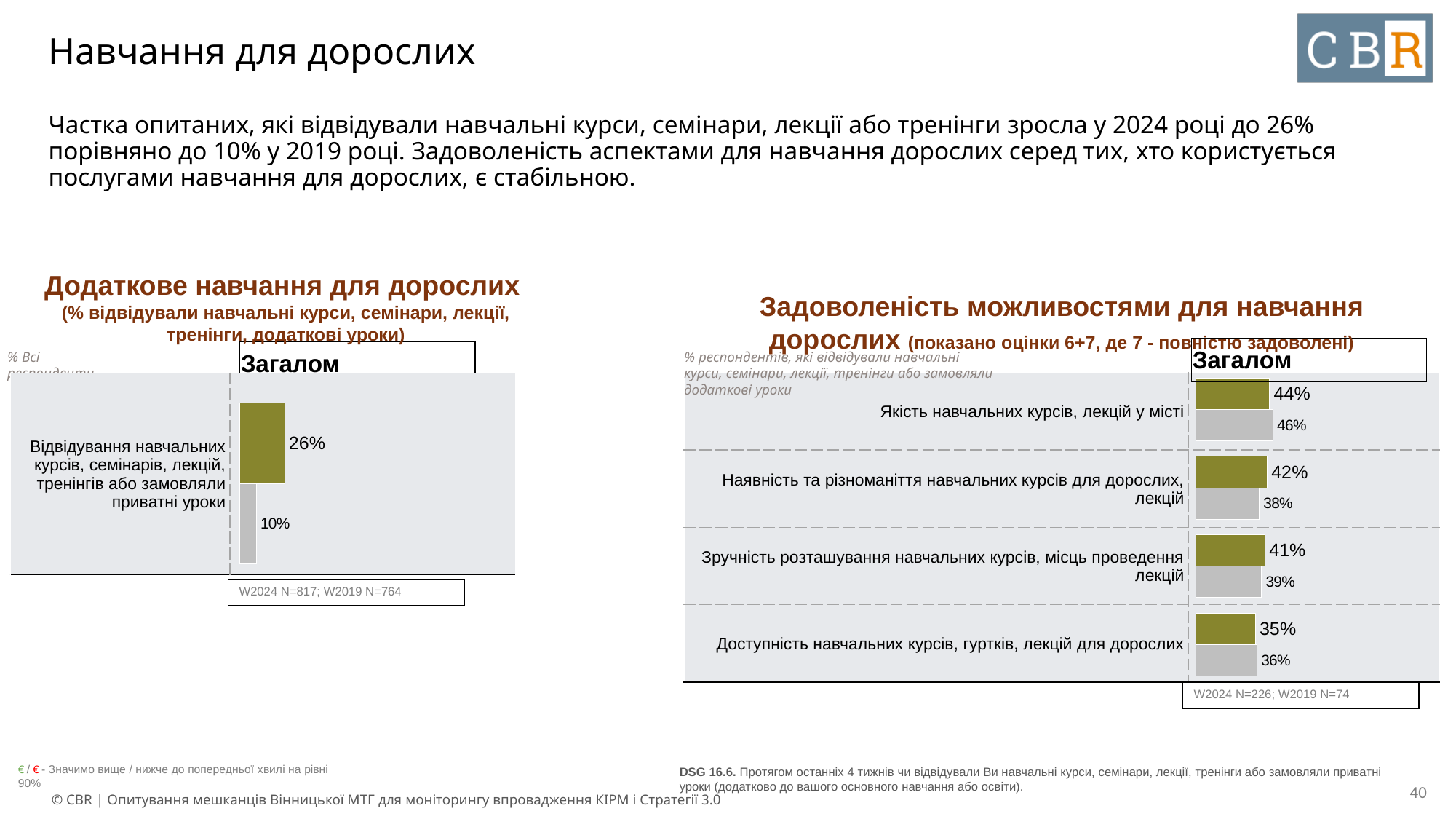
In the chart 'Додаткове навчання для дорослих', what is the value shown on the olive (upper) bar? 26% In the chart 'Задоволеність можливостями для навчання дорослих', what is the olive bar value for 'Якість навчальних курсів, лекцій у місті'? 44% In the chart 'Задоволеність можливостями для навчання дорослих', what is the difference between the olive and grey bar values for 'Наявність та різноманіття навчальних курсів для дорослих, лекцій'? 4 percentage points In the chart 'Задоволеність можливостями для навчання дорослих', which category has the highest olive bar value? Якість навчальних курсів, лекцій у місті What sample sizes are noted below the chart 'Задоволеність можливостями для навчання дорослих'? W2024 N=226; W2019 N=74 How many categories are shown in the chart 'Задоволеність можливостями для навчання дорослих'? 4 In the chart 'Додаткове навчання для дорослих', what is the difference between the olive bar value and the grey bar value? 16 percentage points In the chart 'Задоволеність можливостями для навчання дорослих', what is the grey bar value for 'Наявність та різноманіття навчальних курсів для дорослих, лекцій'? 38% What type of chart is 'Задоволеність можливостями для навчання дорослих'? Bar chart In the chart 'Задоволеність можливостями для навчання дорослих', for 'Доступність навчальних курсів, гуртків, лекцій для дорослих', which is larger: the olive bar (35%) or the grey bar (36%)? The grey bar (36%) In the chart 'Додаткове навчання для дорослих', what is the value shown on the grey (lower) bar? 10% In the chart 'Задоволеність можливостями для навчання дорослих', which category has the lowest olive bar value? Доступність навчальних курсів, гуртків, лекцій для дорослих